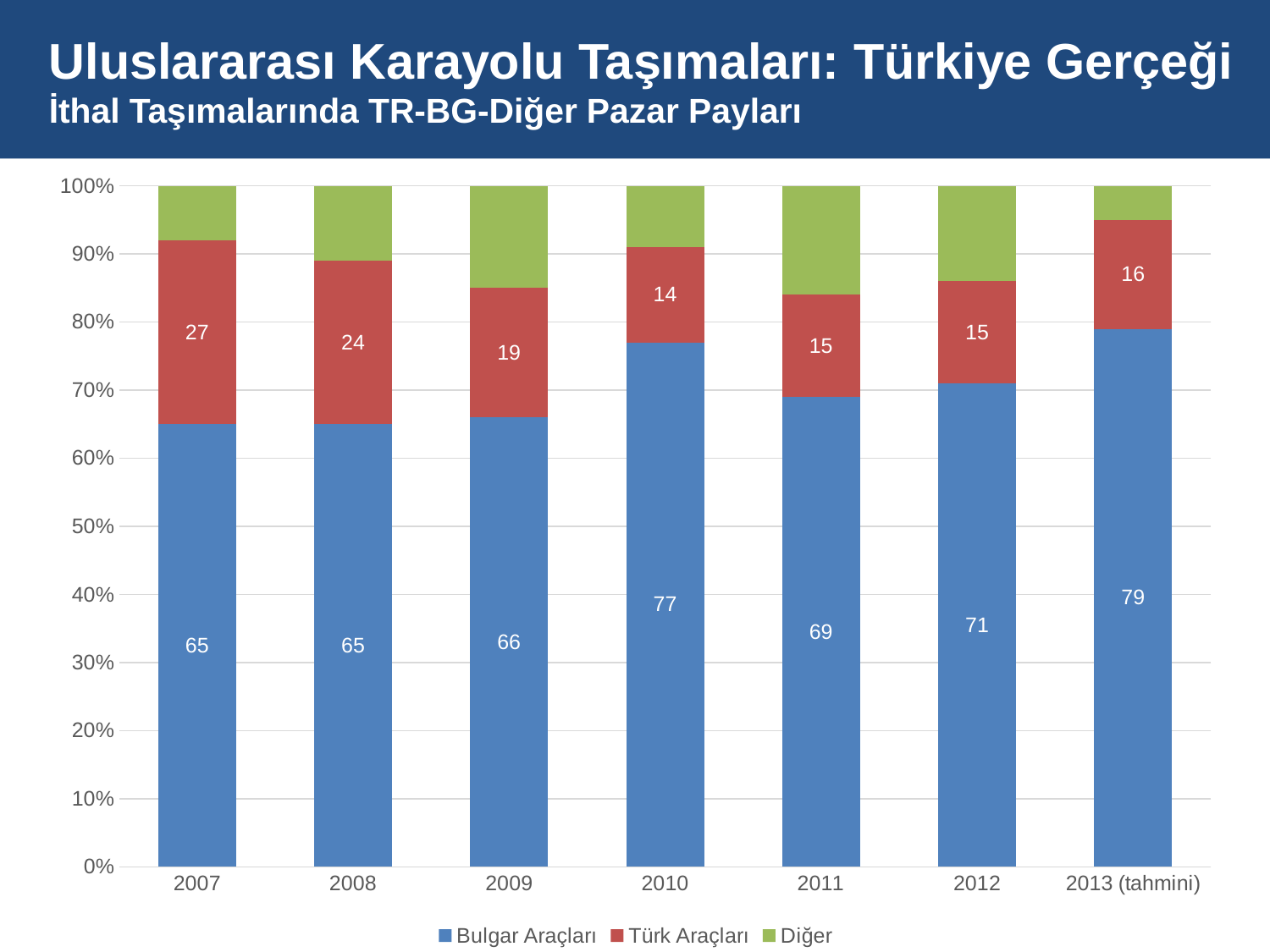
Is the Diğer segment for 2013 (tahmini) greater or less than 10%? less What is the value for Bulgar Araçları in 2010? 77 In which year is the Türk Araçları value the lowest? 2010 What is the value for Türk Araçları in 2007? 27 What is the value for Bulgar Araçları in 2013 (tahmini)? 79 Does the Türk Araçları value rise or fall from 2007 to 2010? fall Which is larger, the Bulgar Araçları value in 2011 or in 2012? 2012 What is the difference between the Türk Araçları values in 2007 and 2013 (tahmini)? 11 How many series does the legend list? 3 What kind of chart is shown on the slide? Stacked bar chart In which year is the Bulgar Araçları value the highest? 2013 (tahmini) How many years are shown on the x axis? 7